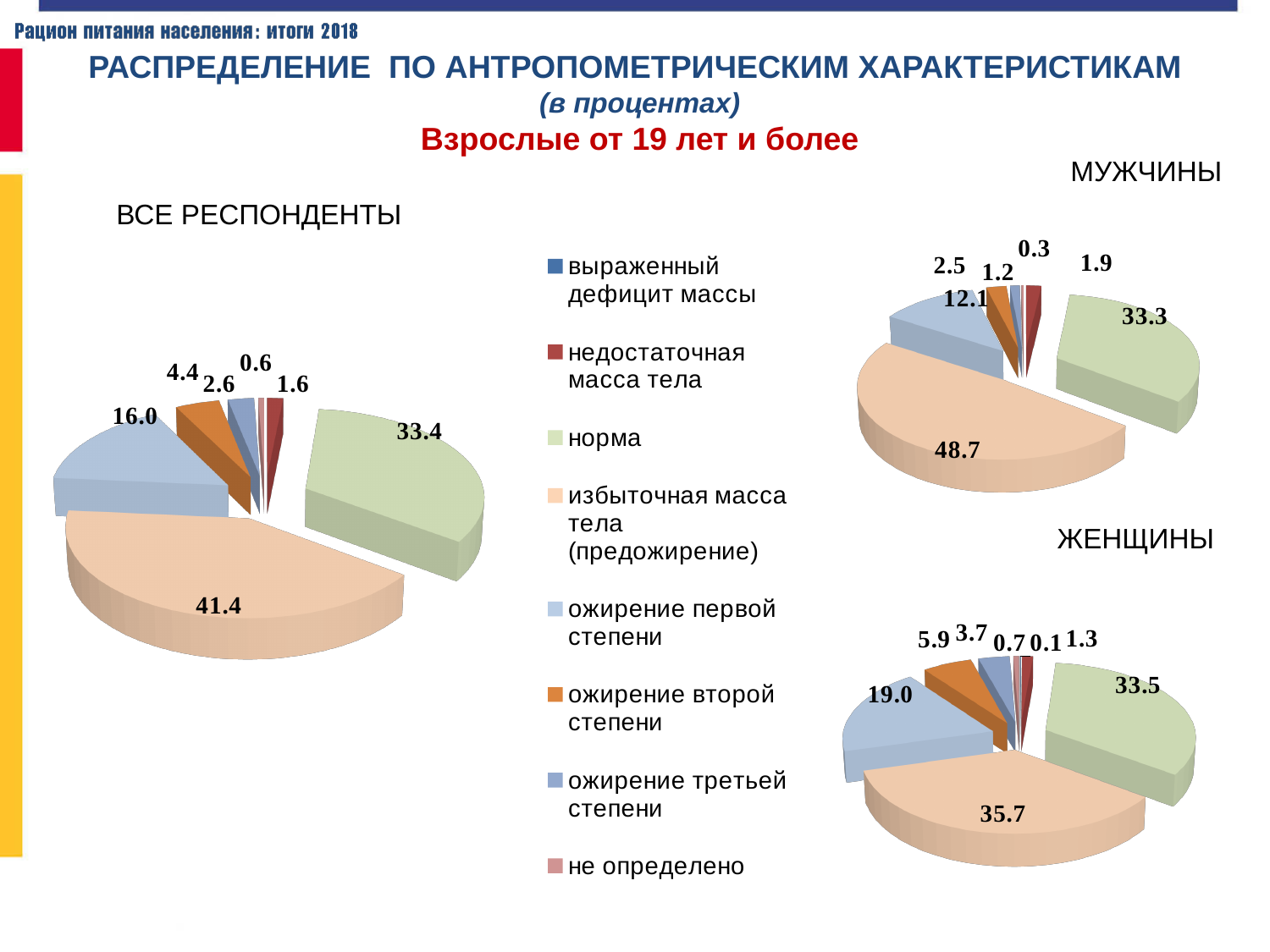
In the 'МУЖЧИНЫ' pie chart, what is the value for 'норма'? 33.3 In the 'ЖЕНЩИНЫ' pie chart, what is the value for 'ожирение первой степени'? 19.0 In the 'МУЖЧИНЫ' pie chart, which category has the largest slice? избыточная масса тела (предожирение) In the 'ВСЕ РЕСПОНДЕНТЫ' pie chart, what is the difference between 'избыточная масса тела (предожирение)' and 'ожирение первой степени'? 25.4 Which is larger: 'ожирение первой степени' in the 'ЖЕНЩИНЫ' chart or in the 'МУЖЧИНЫ' chart? ЖЕНЩИНЫ In the 'ЖЕНЩИНЫ' pie chart, what is the value for 'ожирение второй степени'? 5.9 In the 'ВСЕ РЕСПОНДЕНТЫ' pie chart, what is the value for 'избыточная масса тела (предожирение)'? 41.4 In the 'МУЖЧИНЫ' pie chart, what is the value for 'ожирение первой степени'? 12.1 In the 'ВСЕ РЕСПОНДЕНТЫ' pie chart, which category has the largest slice? избыточная масса тела (предожирение) What type of chart is used for 'ВСЕ РЕСПОНДЕНТЫ'? pie chart In the 'МУЖЧИНЫ' pie chart, what is the difference between 'избыточная масса тела (предожирение)' and 'норма'? 15.4 How many categories does the shared legend list? 8